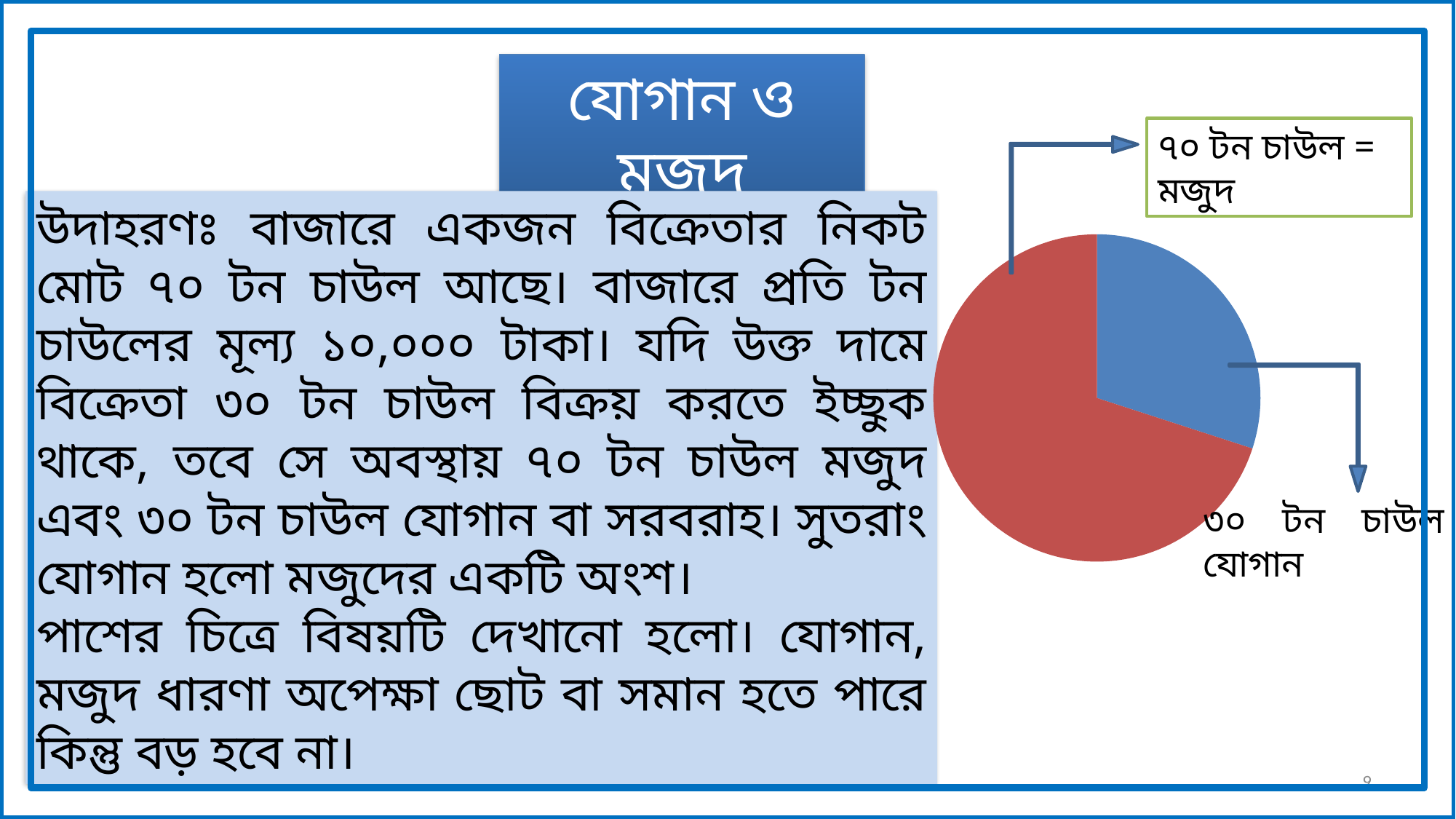
Which slice of the pie chart is the smallest? যোগান Which slice of the pie chart is the largest? মজুদ According to the annotation, how many tons of rice does the যোগান (supply) slice represent? ৩০ টন What colour is the যোগান (৩০ টন) slice of the pie chart? blue Which slice of the pie chart is larger, মজুদ or যোগান? মজুদ What is the difference in tons between the মজুদ slice and the যোগান slice? ৪০ টন How many slices does the pie chart have? 2 According to the annotation, how many tons of rice does the মজুদ (stock) slice represent? ৭০ টন What kind of chart is shown on the right side of the slide? pie chart What colour is the মজুদ (৭০ টন) slice of the pie chart? red